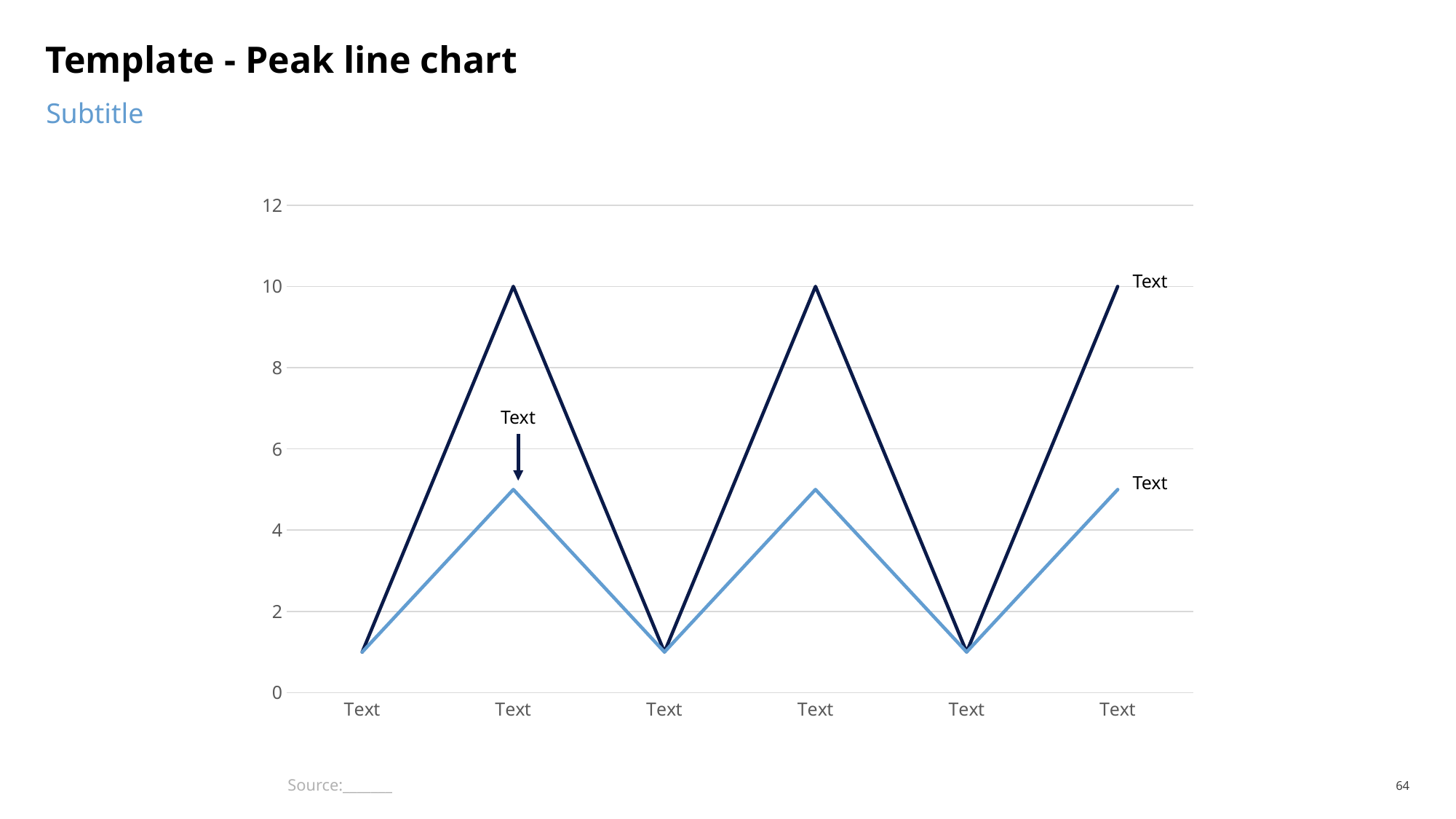
What is the value of the dark blue line at the second category from the left? 10 Is the value of the light blue line at the second category greater or less than 6? less What is the title of the slide? Template - Peak line chart How many categories are shown along the x axis? 6 Is the value of the light blue line at the second category greater or less than 4? greater Does the dark blue line rise or fall from the first category to the second category? rise What is the value of the dark blue line at the last category on the right? 10 At the fourth category from the left, which line has the higher value, the dark blue line or the light blue line? the dark blue line What kind of chart is shown on the slide? line chart Is the value of the dark blue line at the first category greater or less than 2? less What is the highest value reached by the dark blue line? 10 How many lines (series) are plotted on the chart? 2